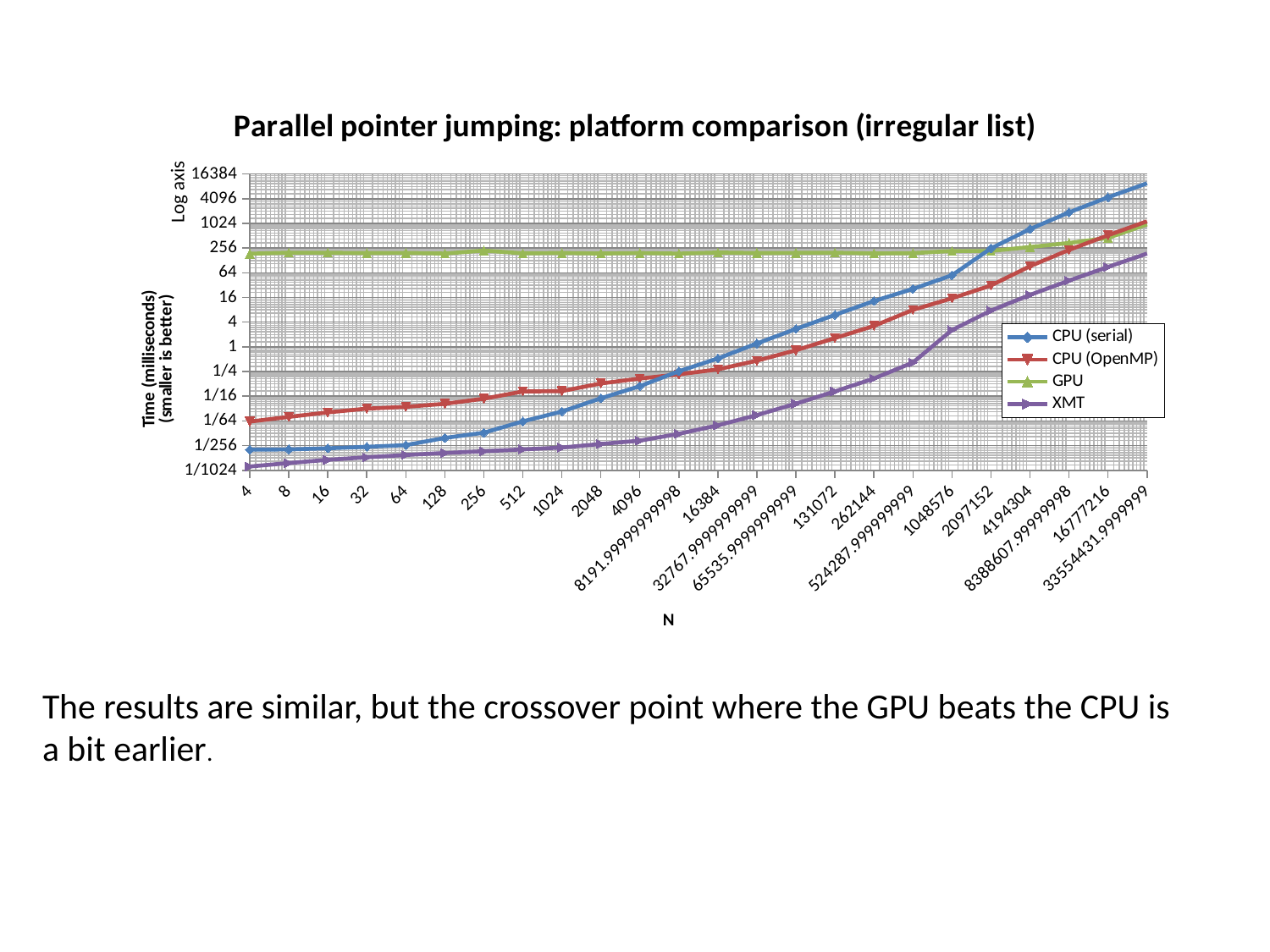
At N = 4, is the value for GPU greater or less than 64? greater What kind of chart is shown on the slide? line chart What is the label of the vertical axis? Time (milliseconds) (smaller is better) How many series does the legend list? 4 How many N values are plotted along the x axis? 24 Which series stays roughly flat across all values of N? GPU At N = 4, which is larger: CPU (OpenMP) or XMT? CPU (OpenMP) At the largest N plotted, which series has the highest time? CPU (serial) At N = 4, is the value for CPU (serial) greater or less than 1/64? less What is the title of the chart? Parallel pointer jumping: platform comparison (irregular list) Does the CPU (serial) series rise or fall as N increases? rises At N = 1048576, which is larger: CPU (serial) or GPU? GPU